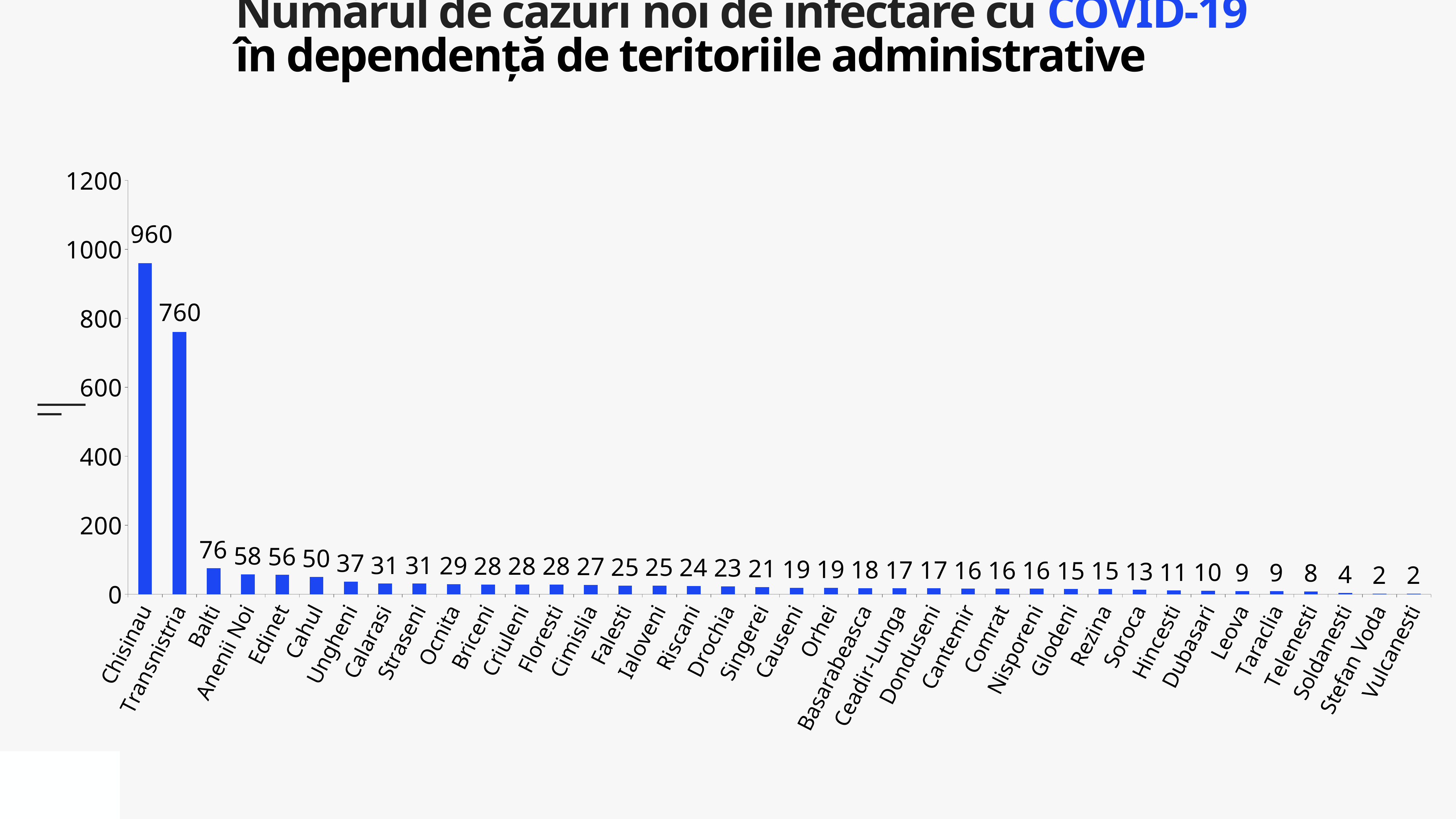
What is the value for Balti? 76 Which is larger, the value for Anenii Noi or the value for Edinet? Anenii Noi What kind of chart is this? bar chart What is the difference between the values for Balti and Cahul? 26 What is the value for Ungheni? 37 What is the difference between the values for Chisinau and Transnistria? 200 Do the values rise or fall from left to right along the x axis? fall How many categories are shown on the x axis? 38 What is the value for Transnistria? 760 What is the value for Chisinau? 960 What is the value for Soroca? 13 Which category has the highest value? Chisinau